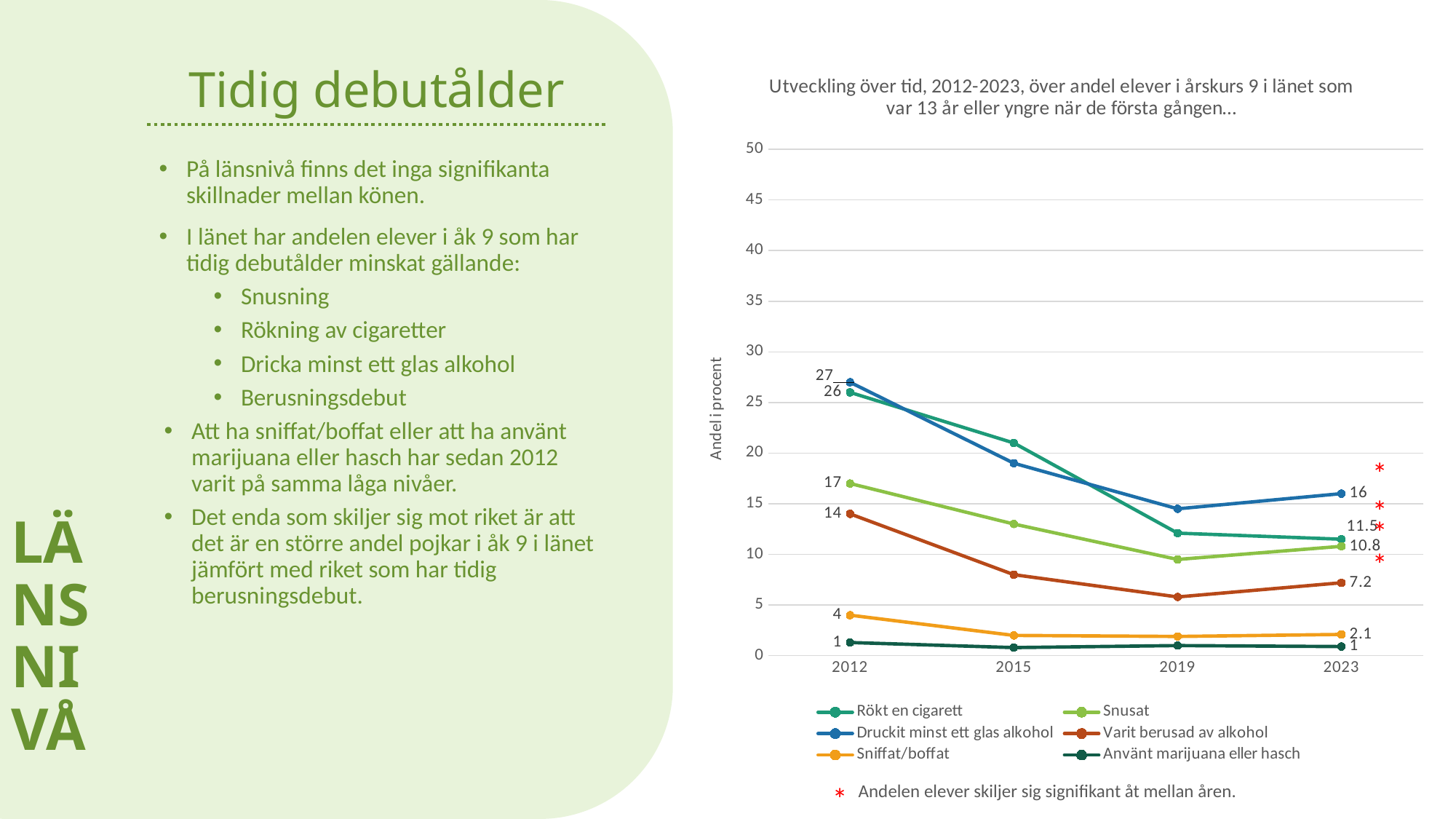
Which series has the highest value in 2012? Druckit minst ett glas alkohol How many years are plotted along the x axis of the chart? 4 Which is larger in 2012: the value for 'Snusat' or the value for 'Varit berusad av alkohol'? Snusat What is the value for 'Varit berusad av alkohol' in 2023? 7.2 Is the value for 'Varit berusad av alkohol' in 2019 greater or less than 10? less What is the value for 'Sniffat/boffat' in 2023? 2.1 What is the value for 'Druckit minst ett glas alkohol' in 2012? 27 Which series has the lowest value in 2023? Använt marijuana eller hasch What kind of chart is shown on the slide? Line chart How many series does the chart's legend list? 6 By how much did the value for 'Druckit minst ett glas alkohol' fall between 2012 and 2023? 11 What is the value for 'Rökt en cigarett' in 2012? 26